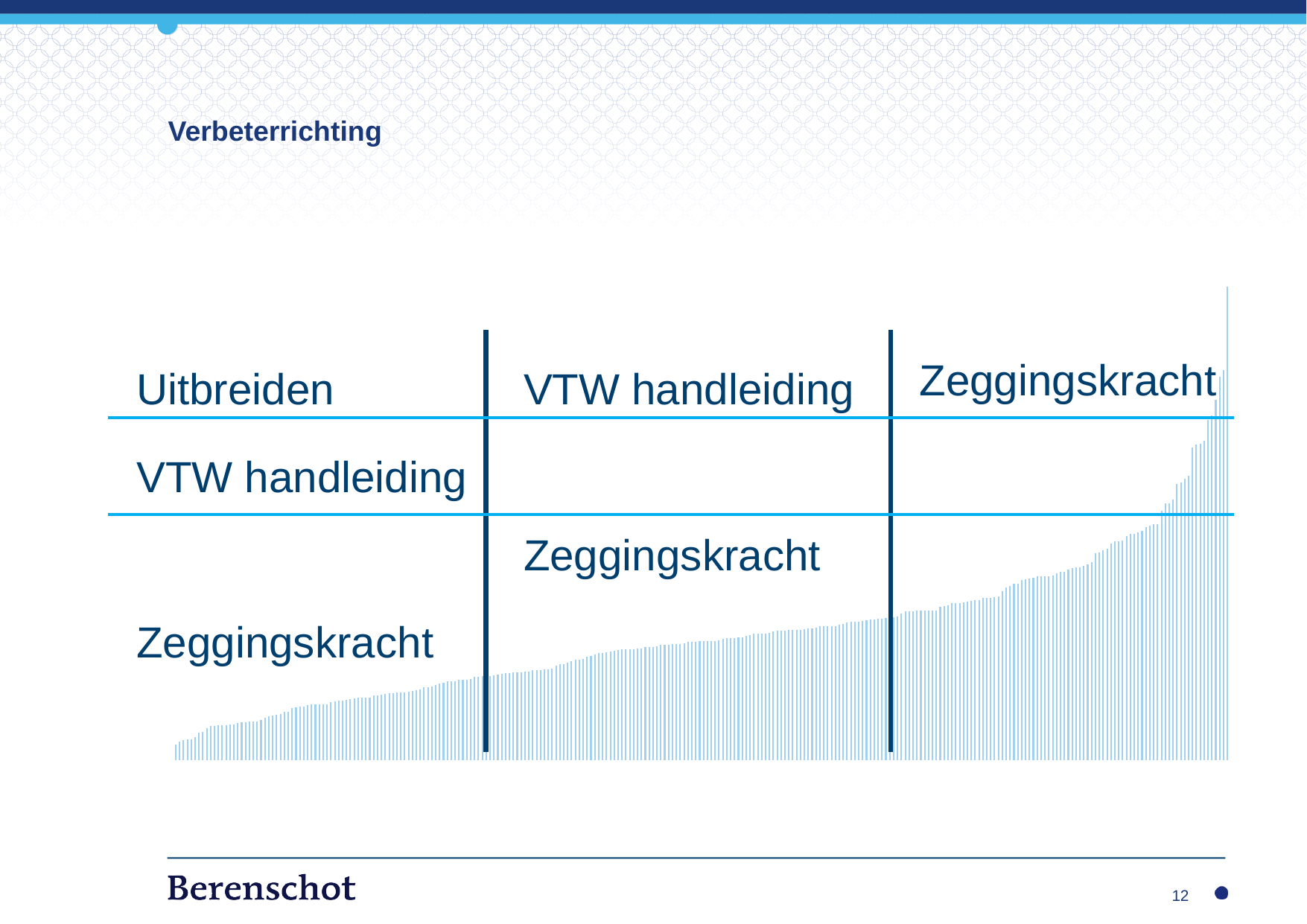
What kind of chart is shown on the slide? bar chart Is the tallest bar on the left side or the right side of the chart? right side Do the bar heights rise or fall from left to right across the chart? rise Into how many vertical sections do the dark vertical lines divide the chart area? 3 What is the title of the slide containing the chart? Verbeterrichting Is the shortest bar on the left side or the right side of the chart? left side